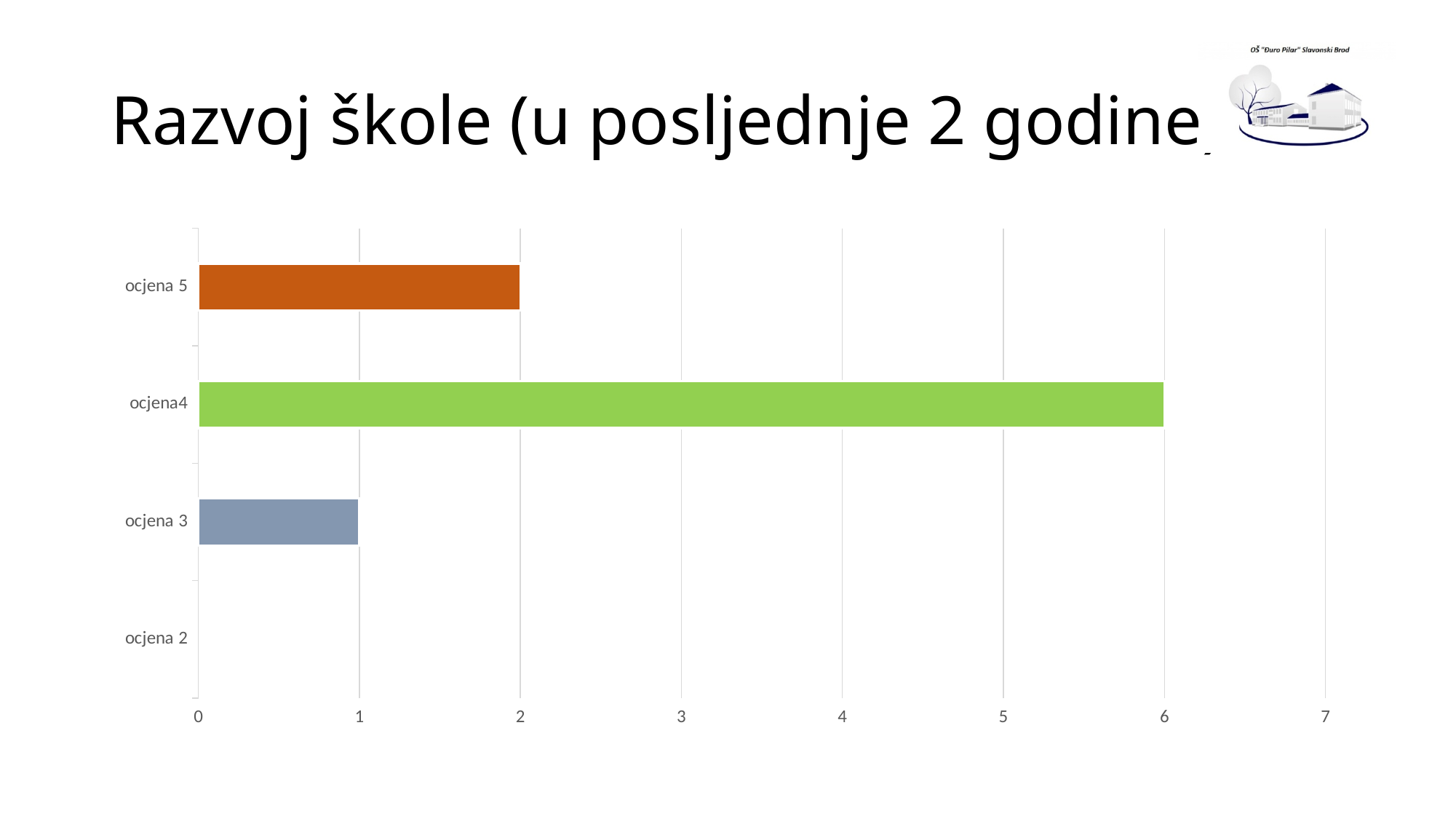
What is the difference between the values for ocjena 5 and ocjena 3? 1 What kind of chart is shown on the slide? bar chart What is the value for ocjena 5? 2 What is the value for ocjena 3? 1 How many categories are shown on the chart? 4 Is the value for ocjena4 greater or less than 5? greater Which category has the highest value? ocjena4 Which is larger, the value for ocjena 5 or the value for ocjena 3? ocjena 5 What is the value for ocjena4? 6 What colour is the bar for ocjena4? green What is the difference between the values for ocjena4 and ocjena 5? 4 Which category has the lowest value? ocjena 2